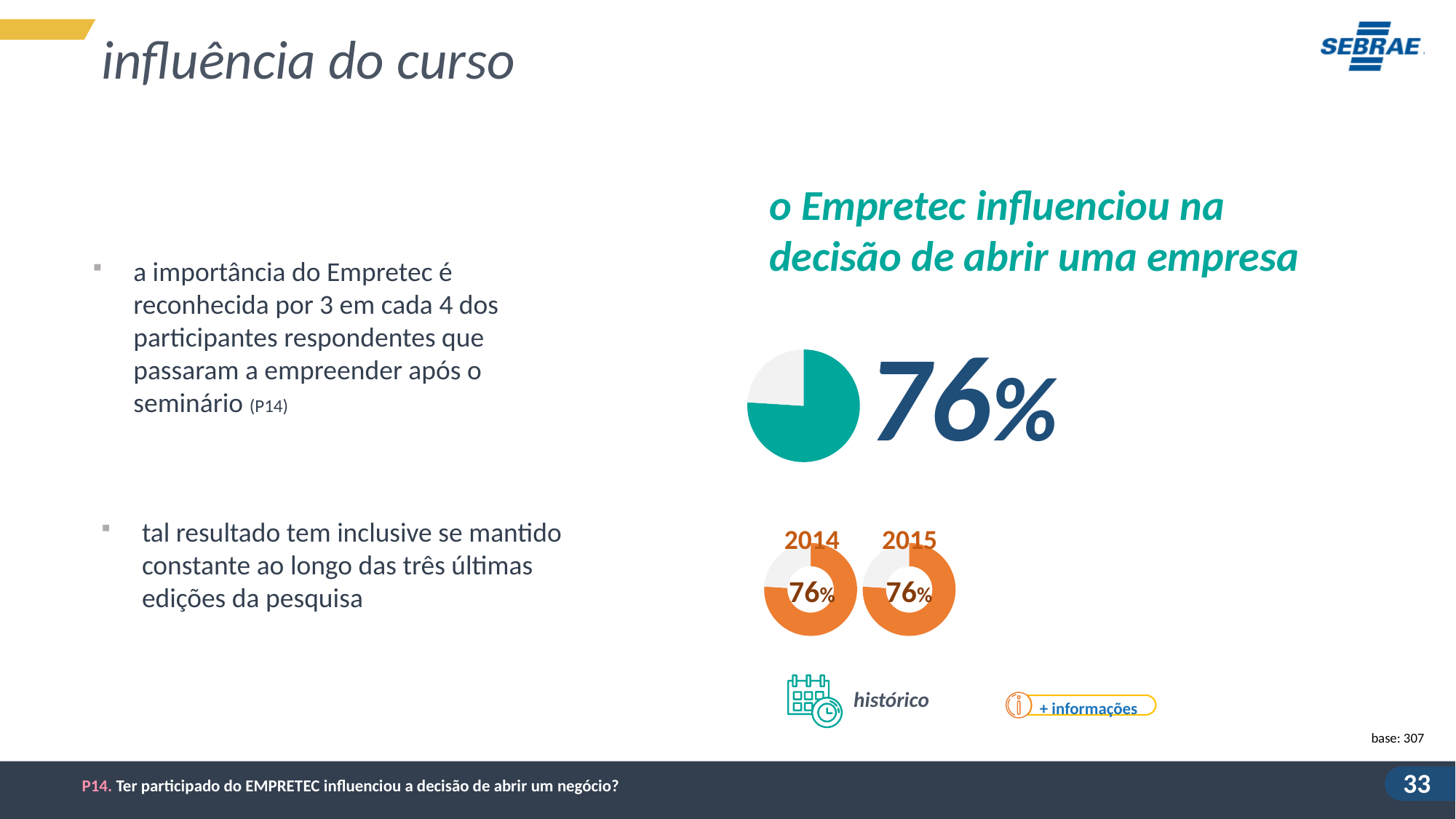
In the large pie chart, what percentage of respondents said Empretec influenced their decision to open a company? 76% How many small historical donut charts are shown below the main pie chart? 2 In the small historical charts, what is the value shown for 2015? 76% In the small historical charts, what is the value shown for 2014? 76% Is the value shown in the large pie chart greater or less than 50%? greater What is the title written above the large pie chart? o Empretec influenciou na decisão de abrir uma empresa Does the value in the historical donut charts rise, fall or stay the same from 2014 to 2015? stays the same In the large pie chart, what share of the pie is not filled by the teal 76% slice? 24% What colour are the small historical donut charts for 2014 and 2015? orange Which years are labelled on the small historical donut charts? 2014 and 2015 What is the difference between the 2015 value and the 2014 value in the historical donut charts? 0% What kind of chart is the large teal chart next to the 76% figure? pie chart